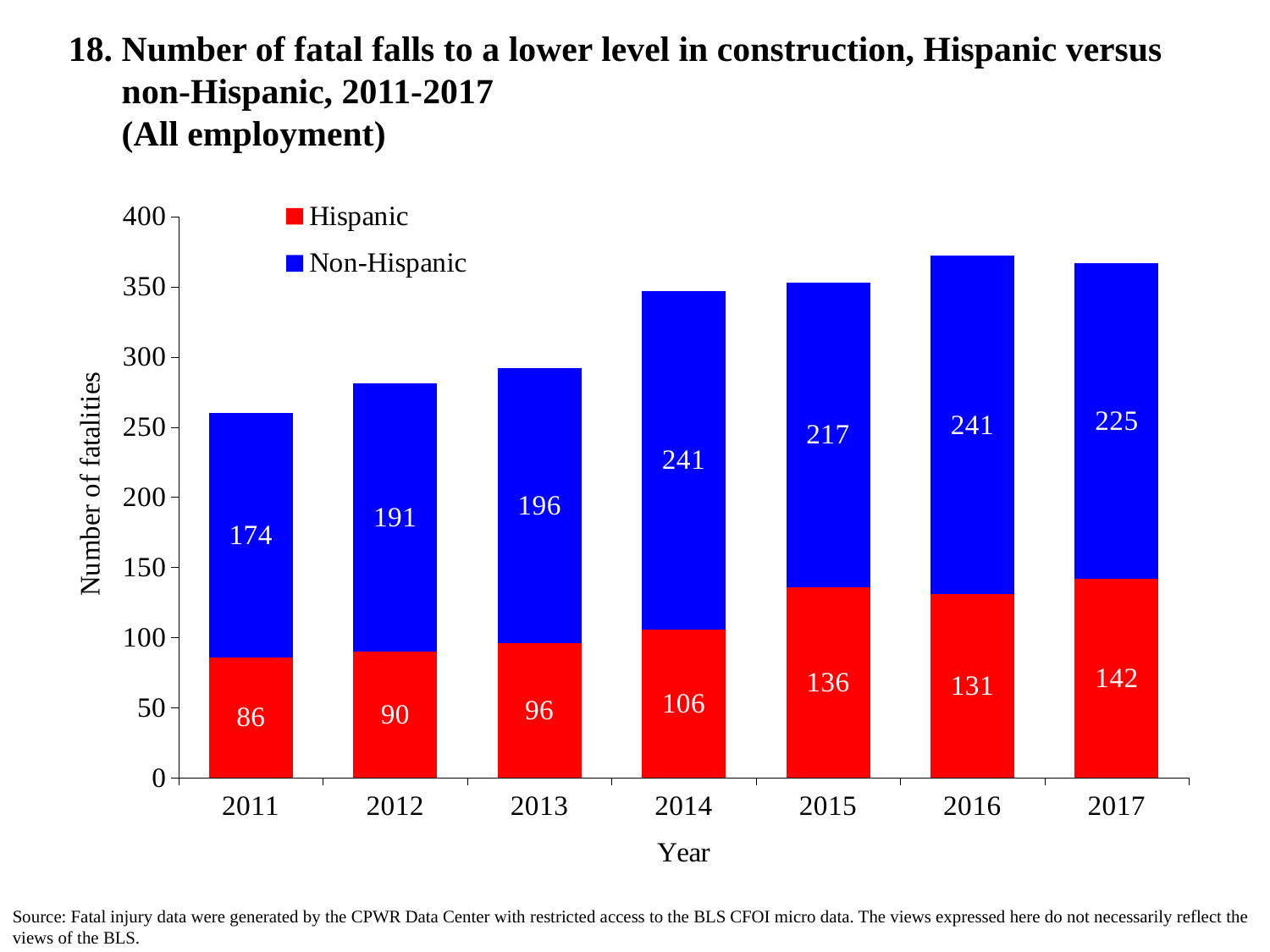
What is the difference between Non-Hispanic and Hispanic fatalities in 2015? 81 Which colour represents the Hispanic series? red What is the total number of fatalities in 2017 (Hispanic plus Non-Hispanic)? 367 What kind of chart is shown on the slide? stacked bar chart Which year has the lowest number of Non-Hispanic fatalities? 2011 Which year has the highest number of Hispanic fatalities? 2017 What is the number of Non-Hispanic fatal falls to a lower level in 2016? 241 What is the number of Hispanic fatal falls to a lower level in 2014? 106 Which is larger, the Hispanic value in 2016 or the Hispanic value in 2015? 2015 How many series does the legend list? 2 Is the total height of the 2014 stacked bar greater or less than 300? greater How many years are shown on the x axis? 7